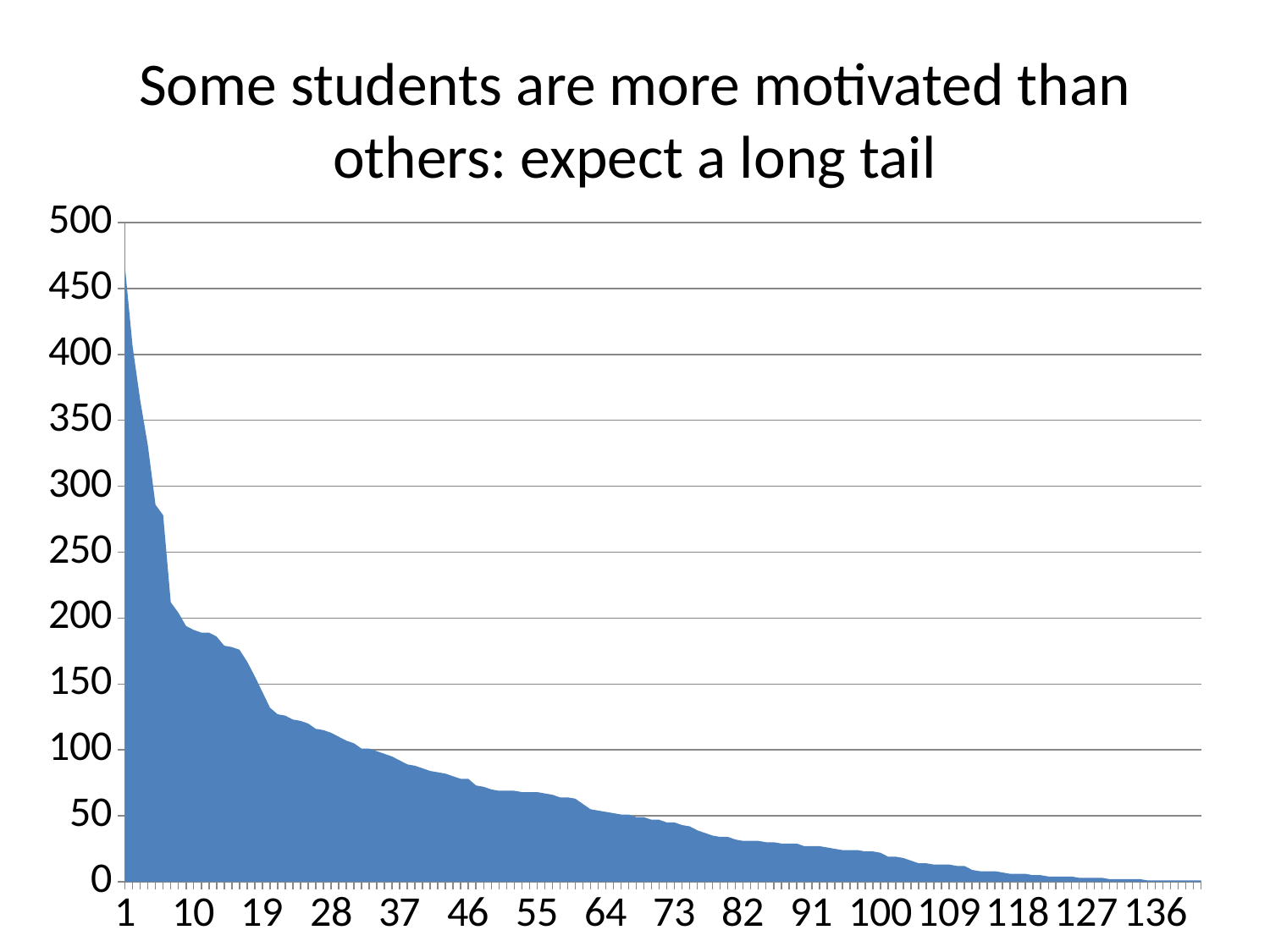
Is the value at x = 28 greater or less than 100? greater Is the value at x = 46 greater or less than 100? less What is the title of the chart? Some students are more motivated than others: expect a long tail Is the value at x = 100 greater or less than 50? less Which x-axis category has the highest value? 1 Which is larger, the value at x = 10 or the value at x = 55? x = 10 What is the highest value shown on the y axis? 500 Do the values rise or fall as you move from left to right along the x axis? fall What kind of chart is shown on the slide? area chart